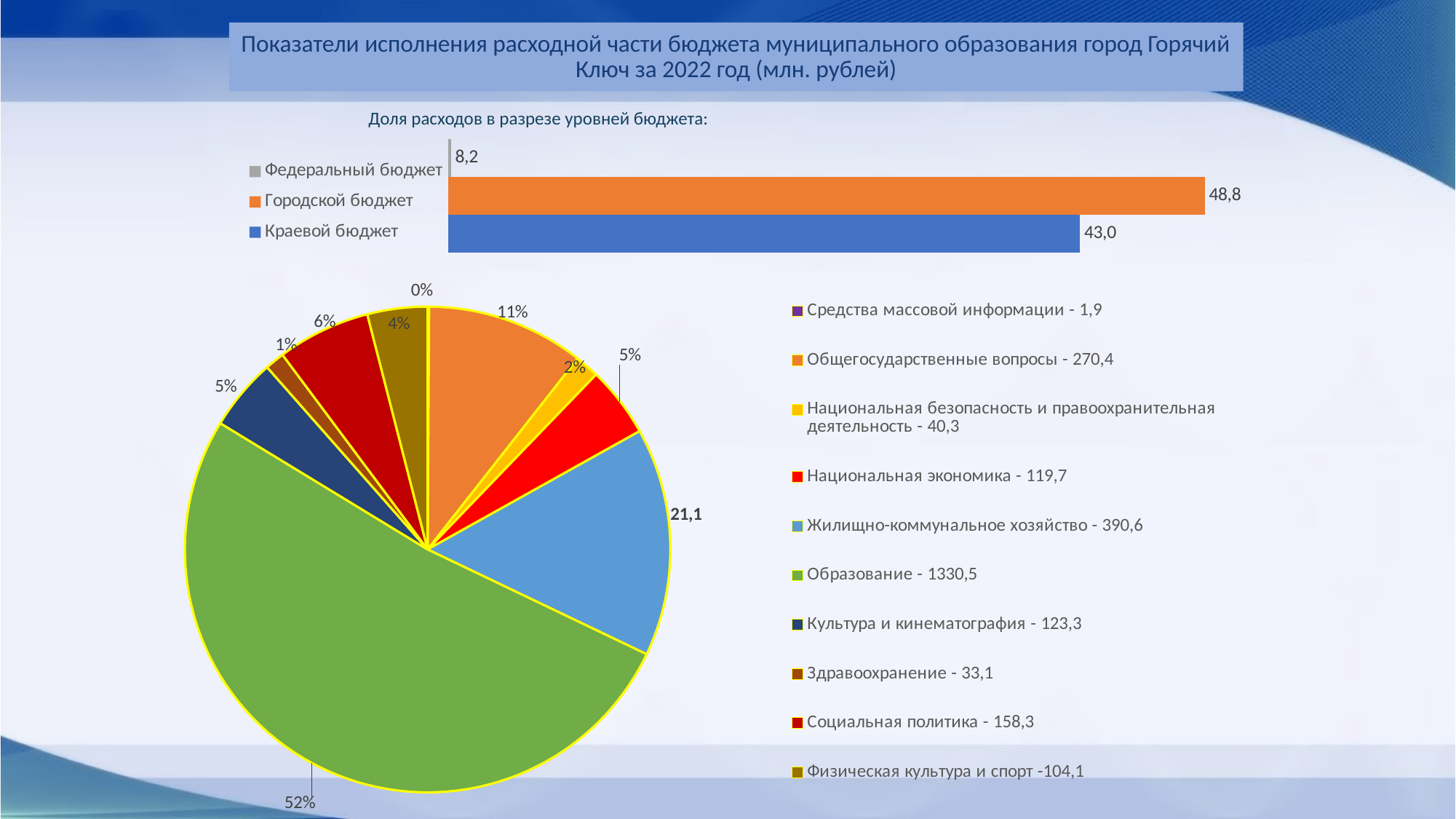
In the bar chart 'Доля расходов в разрезе уровней бюджета', what is the difference between Городской бюджет and Краевой бюджет? 5,8 In the bar chart 'Доля расходов в разрезе уровней бюджета', how many categories are shown? 3 In the bar chart 'Доля расходов в разрезе уровней бюджета', which budget level has the lowest value? Федеральный бюджет How many categories does the pie chart's legend list? 10 What kind of chart is the upper chart 'Доля расходов в разрезе уровней бюджета'? Bar chart In the bar chart 'Доля расходов в разрезе уровней бюджета', which budget level has the highest value? Городской бюджет In the pie chart, what share of the pie does Образование take? 52% In the bar chart 'Доля расходов в разрезе уровней бюджета', what is the value for Городской бюджет? 48,8 In the bar chart 'Доля расходов в разрезе уровней бюджета', what is the value for Федеральный бюджет? 8,2 In the pie chart, which category has the largest slice? Образование In the pie chart, which is larger: Социальная политика or Здравоохранение? Социальная политика In the pie chart, what value is listed in the legend for Образование? 1330,5